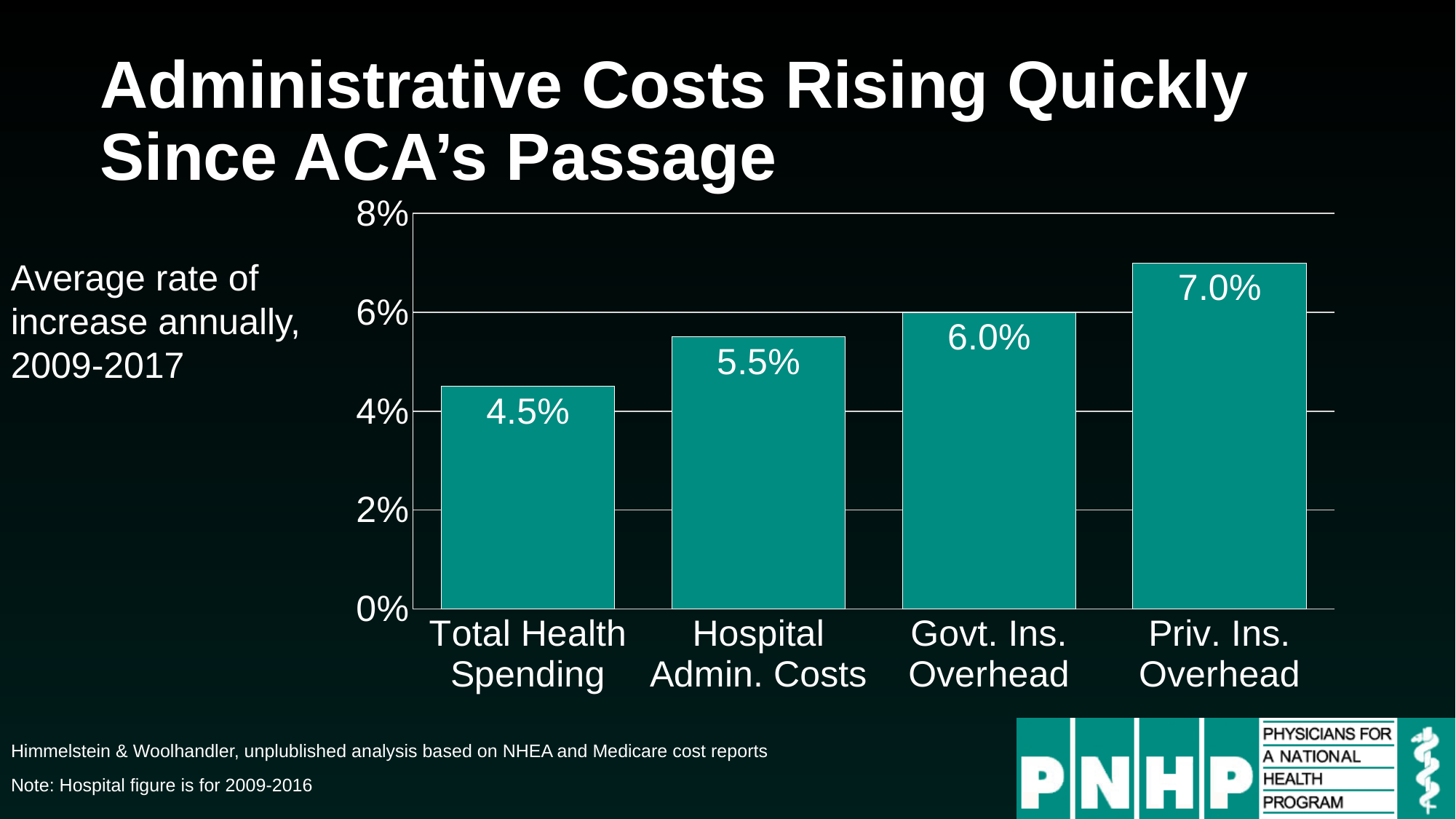
What is the average annual rate of increase for Total Health Spending? 4.5% What is the difference between the values for Priv. Ins. Overhead and Total Health Spending? 2.5% Which is larger, the value for Govt. Ins. Overhead or Hospital Admin. Costs? Govt. Ins. Overhead Do the values rise or fall from left to right across the categories? Rise What is the value shown for Priv. Ins. Overhead? 7.0% Which category has the lowest average annual rate of increase? Total Health Spending What is the value shown for Hospital Admin. Costs? 5.5% Is the value for Hospital Admin. Costs greater or less than 4%? greater How many categories are shown in the chart? 4 What kind of chart is shown on the slide? Bar chart Which category has the highest average annual rate of increase? Priv. Ins. Overhead What is the value shown for Govt. Ins. Overhead? 6.0%